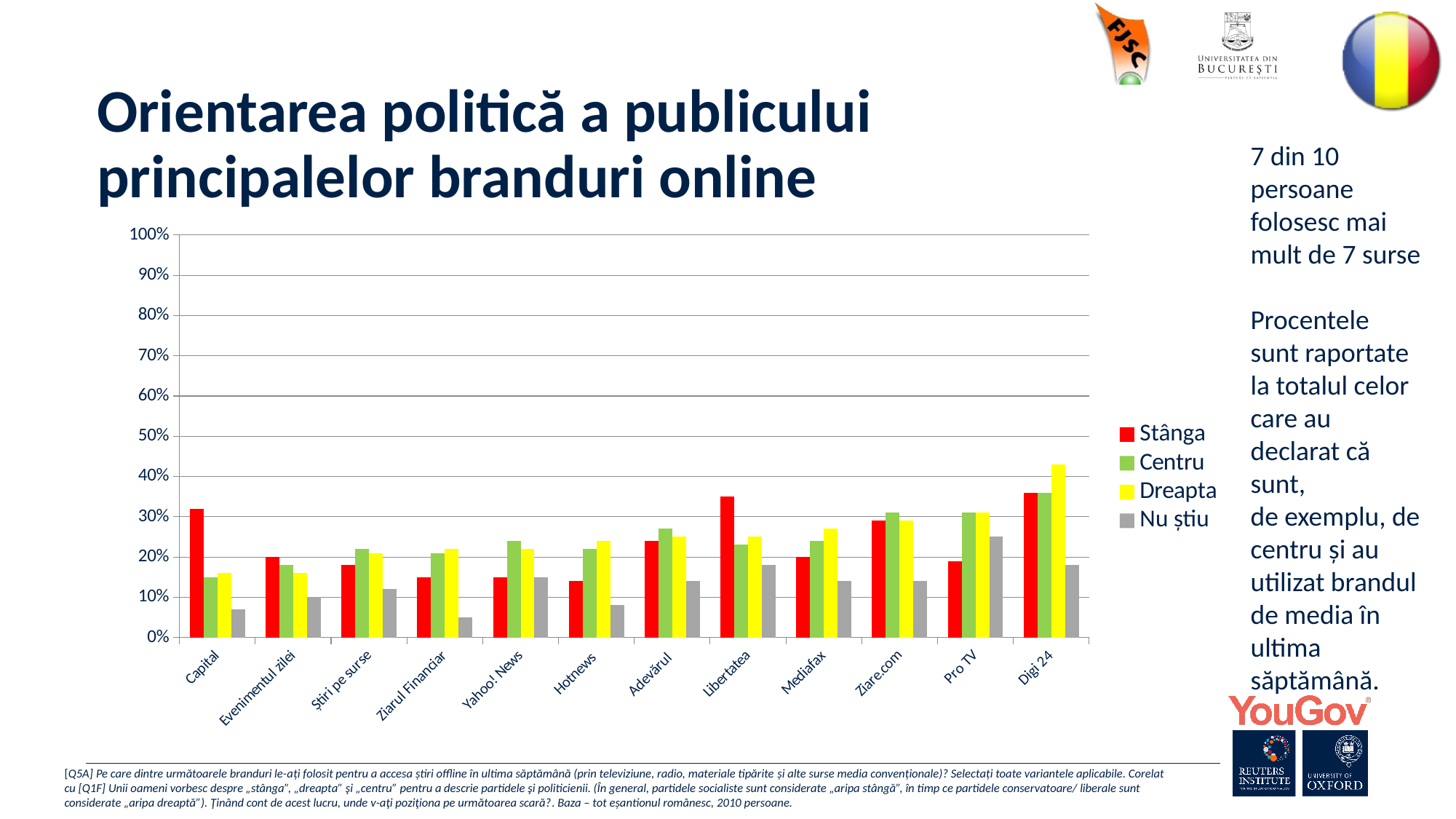
Is the Dreapta value for Digi 24 greater or less than 40%? greater Which brand has the highest value for the Nu știu series? Pro TV Which brand has the highest value for the Dreapta series? Digi 24 Which brand has the lowest value for the Nu știu series? Ziarul Financiar How many media brands (categories) are shown on the x axis of the chart? 12 Is the Stânga value for Capital greater or less than 30%? greater For Capital, which is larger: the Stânga value or the Centru value? Stânga What colour represents the Dreapta series in the chart? yellow For Pro TV, which is larger: the Stânga value or the Centru value? Centru What kind of chart is shown on the slide? bar chart How many series does the chart's legend list? 4 Is the Nu știu value for Ziarul Financiar greater or less than 10%? less